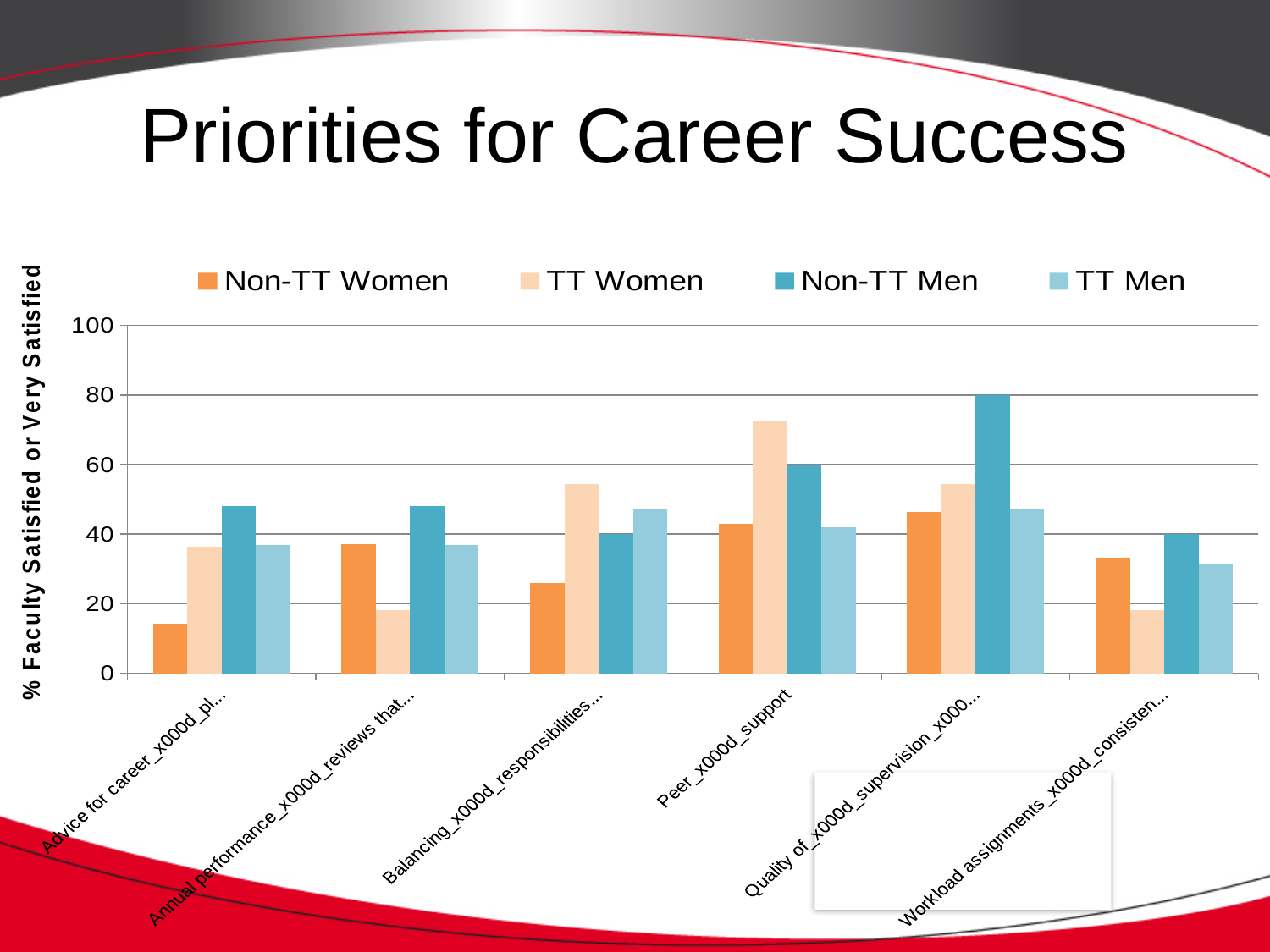
Which series has the highest value in the Quality of supervision category? Non-TT Men Which series has the lowest value in the Workload assignments category? TT Women In the Annual performance reviews category, which is larger: Non-TT Women or TT Women? Non-TT Women How many categories are plotted along the x axis? 6 Is the value for Non-TT Women in the Advice for career category greater or less than 20? less How many series does the legend list? 4 Which series has the highest value in the Peer support category? TT Women Is the value for Non-TT Men in the Quality of supervision category greater or less than 60? greater What kind of chart is shown on the slide? bar chart Is the value for TT Women in the Peer support category greater or less than 60? greater What is the title of the y axis? % Faculty Satisfied or Very Satisfied